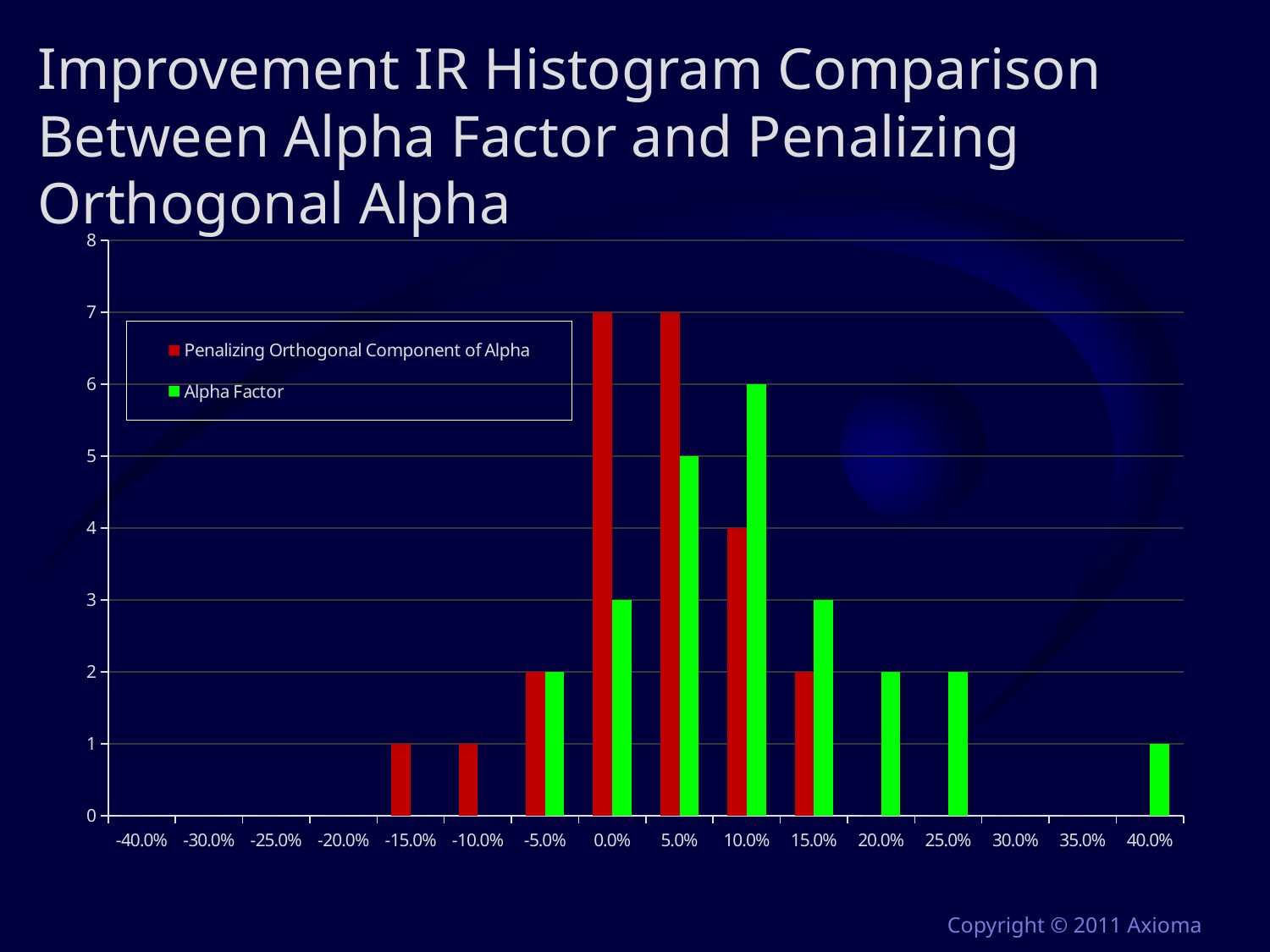
What is the value of the Alpha Factor series at 10.0%? 6 What is the difference between the Penalizing Orthogonal Component of Alpha value and the Alpha Factor value at 0.0%? 4 What is the value of the Alpha Factor series at 40.0%? 1 At which category does the Alpha Factor series reach its highest value? 10.0% How many series does the legend list? 2 What type of chart is shown on the slide? bar chart How many categories are shown on the x axis? 16 At 10.0%, which series has the larger value: Penalizing Orthogonal Component of Alpha or Alpha Factor? Alpha Factor What is the value of the Penalizing Orthogonal Component of Alpha series at 15.0%? 2 What is the value of the Alpha Factor series at 5.0%? 5 What colour represents the Alpha Factor series? green What is the value of the Penalizing Orthogonal Component of Alpha series at 0.0%? 7